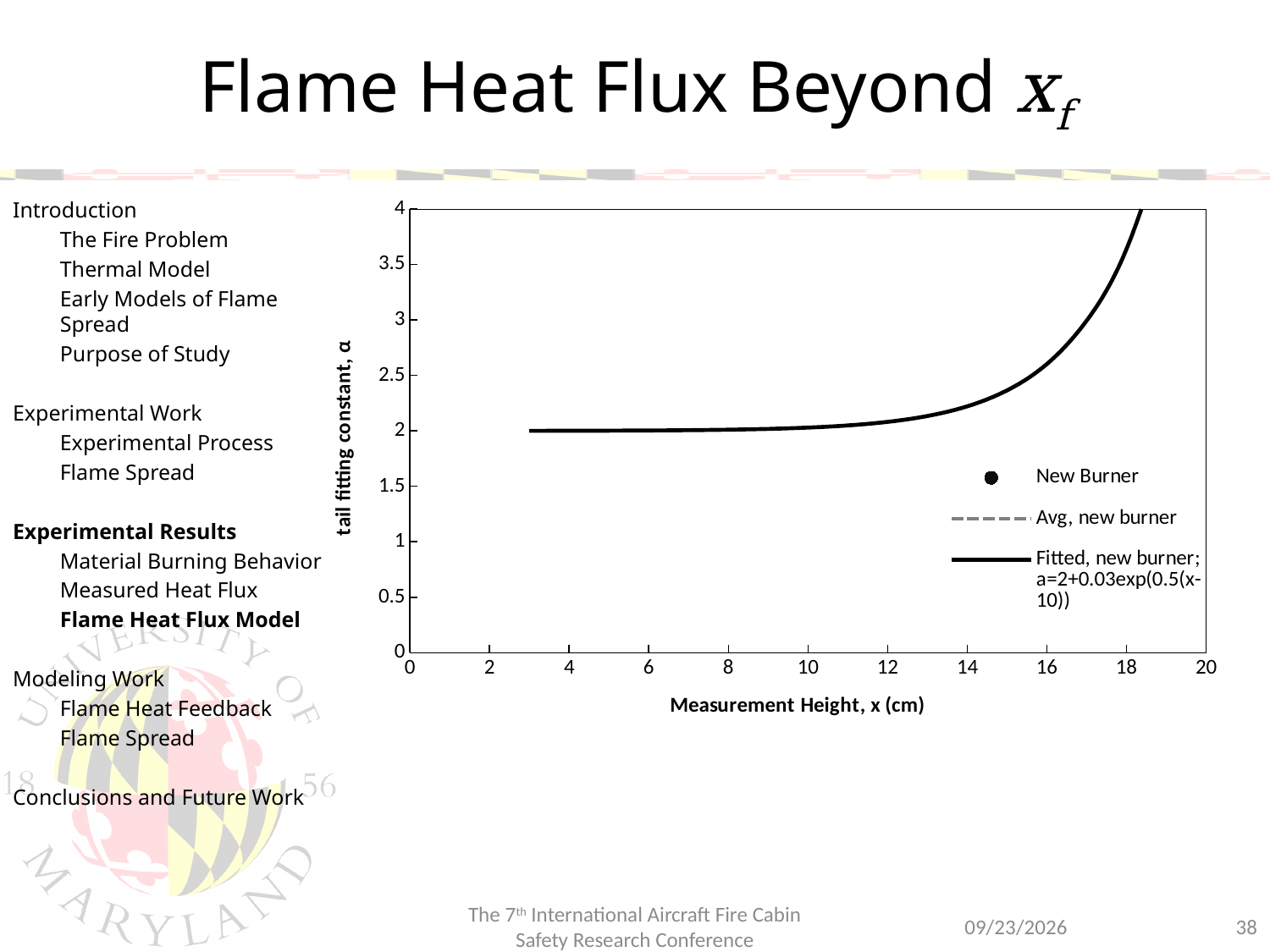
Is the value of the fitted curve at a measurement height of 10 cm greater or less than 3? less Is the value of the fitted curve at a measurement height of 18 cm greater or less than 3? greater How many series does the legend list? 3 Is the value of the fitted curve at a measurement height of 16 cm greater or less than 2? greater What kind of chart is shown on the slide? line chart What is the label of the x axis? Measurement Height, x (cm) Does the fitted curve rise or fall as measurement height increases? rises What is the label of the y axis? tail fitting constant, α